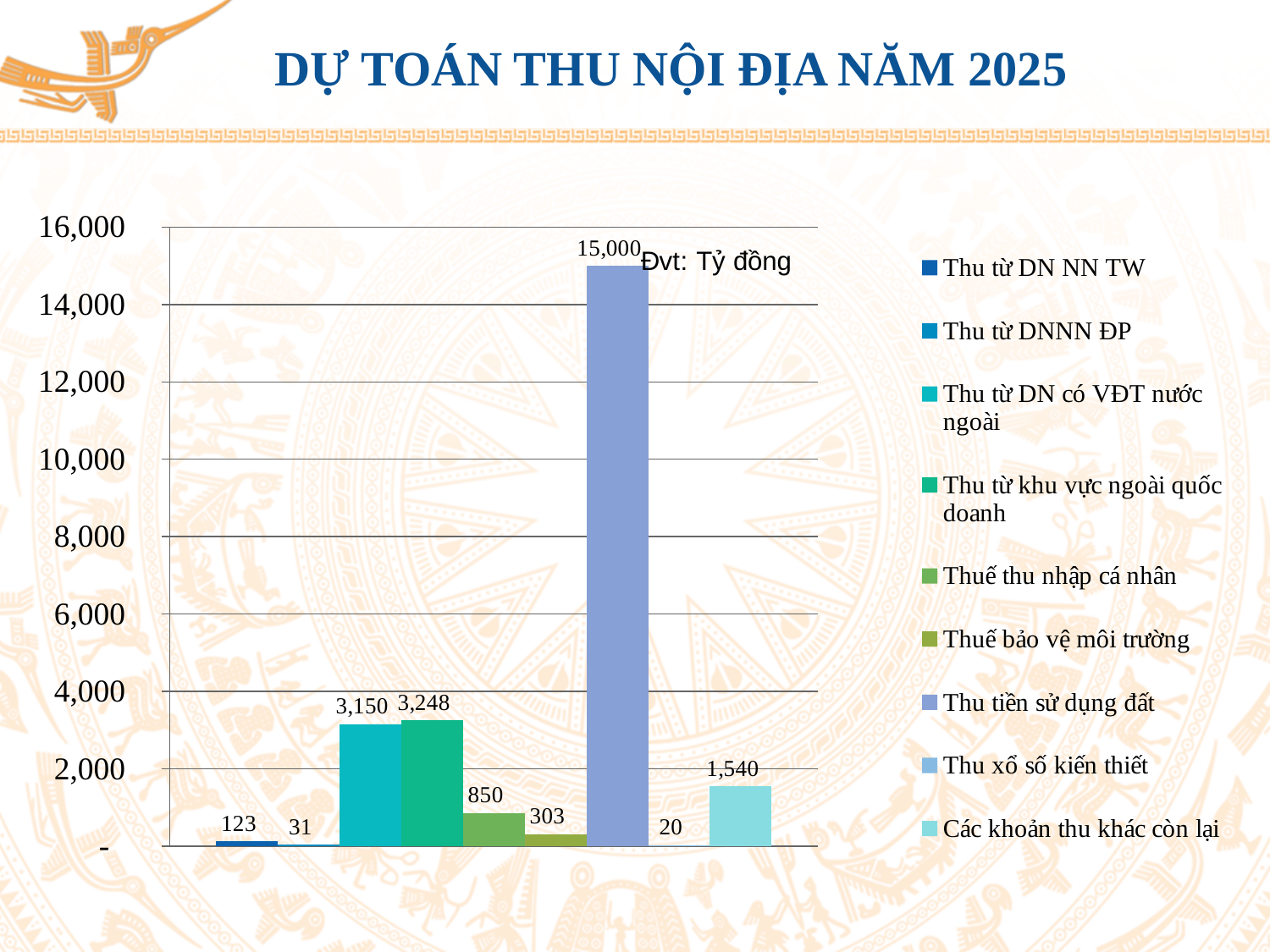
What is the value for Thu xổ số kiến thiết? 20 What kind of chart is shown on the slide? bar chart What unit is stated on the chart? Tỷ đồng How many series does the legend list? 9 Which series has the highest value? Thu tiền sử dụng đất Which is larger, Các khoản thu khác còn lại or Thuế thu nhập cá nhân? Các khoản thu khác còn lại What is the value for Thu từ DN có VĐT nước ngoài? 3,150 What is the value for Thuế thu nhập cá nhân? 850 What is the difference between Thu từ khu vực ngoài quốc doanh and Thu từ DN có VĐT nước ngoài? 98 Is the value for Thu tiền sử dụng đất greater or less than 14,000? greater What is the value for Thu tiền sử dụng đất? 15,000 Which series has the lowest value? Thu xổ số kiến thiết